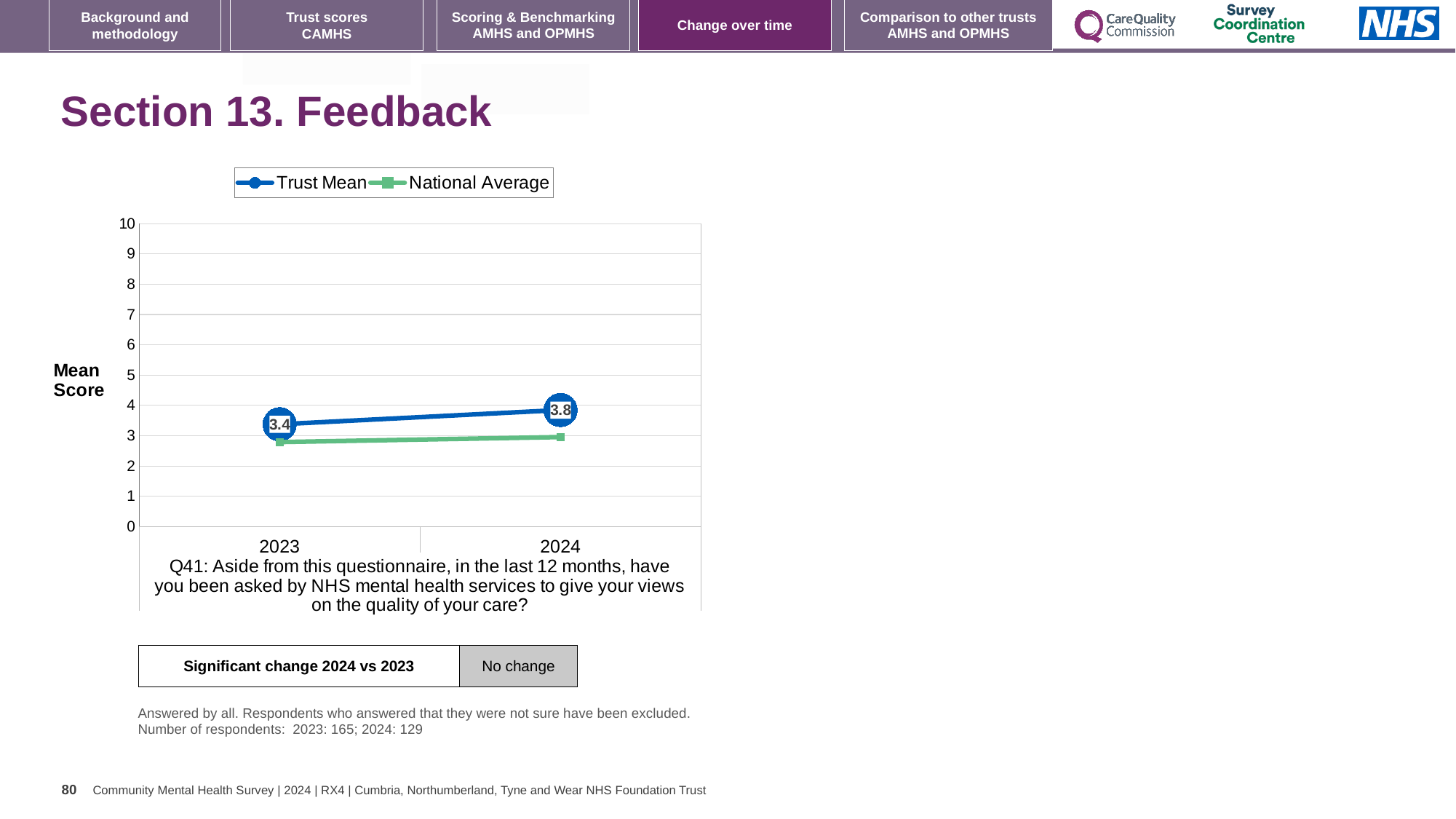
What is the Trust Mean score for 2024? 3.8 Is the Trust Mean for 2024 greater or less than 4? less Which year has the lower Trust Mean score? 2023 Is the Trust Mean for 2024 greater or less than the National Average for 2024? greater What is the difference between the Trust Mean scores for 2024 and 2023? 0.4 Is the National Average for 2023 greater or less than 3? less Which year has the higher Trust Mean score? 2024 Does the Trust Mean rise or fall from 2023 to 2024? rise What is the Trust Mean score for 2023? 3.4 How many series does the legend list? 2 How many years are shown on the x axis? 2 What kind of chart is shown? line chart